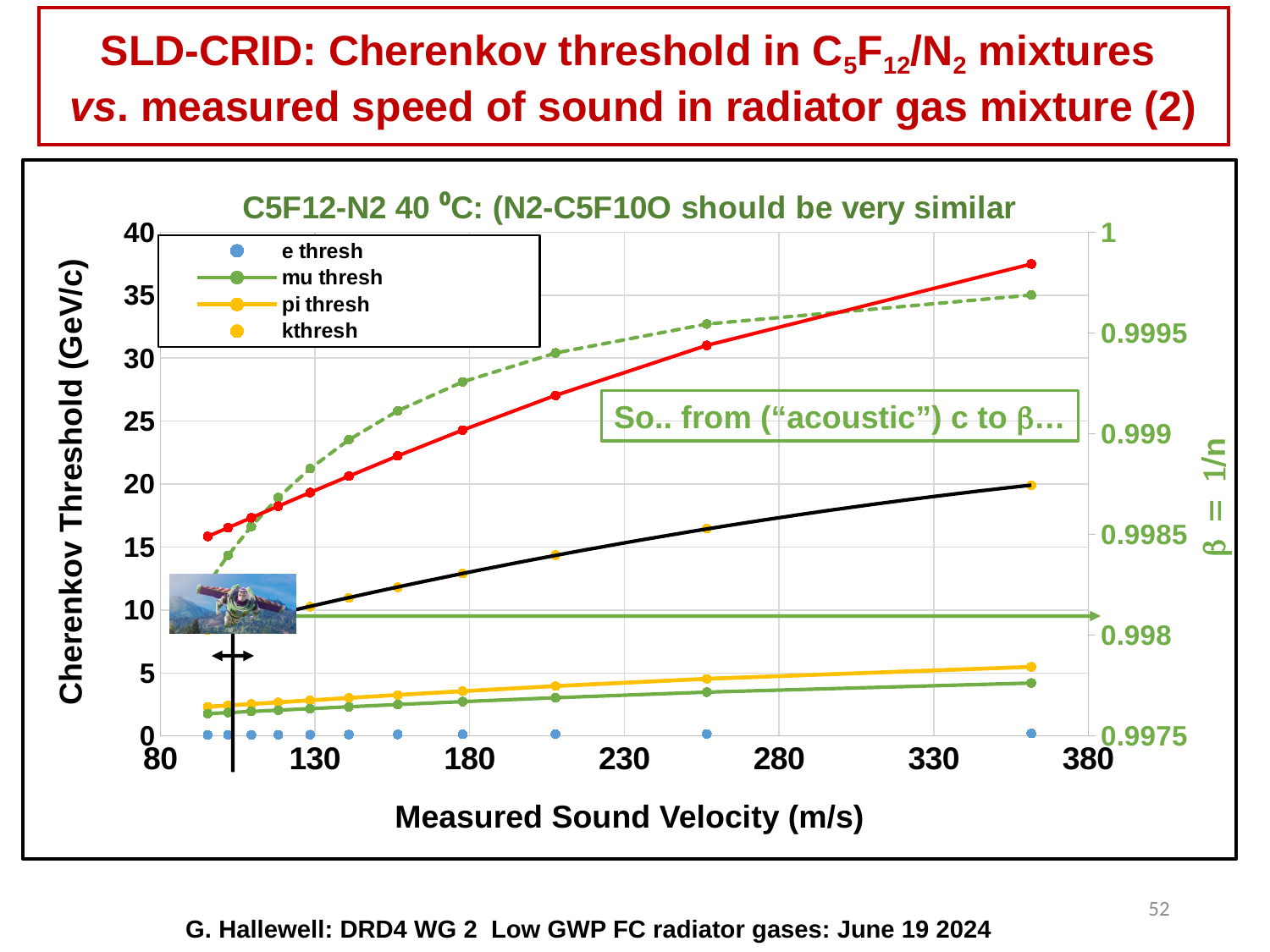
What is the title of the left y axis? Cherenkov Threshold (GeV/c) Is the value of the pi thresh series at its leftmost point greater or less than 10 GeV/c? less Is the value of the mu thresh series at its rightmost point greater or less than 5 GeV/c? less What kind of chart is shown on the slide? line chart How many series does the chart legend list? 4 What is the title of the x axis? Measured Sound Velocity (m/s) Does the mu thresh series rise or fall as measured sound velocity increases? rise Does the e thresh series rise, fall, or stay flat along the x axis? stay flat Is the value of the e thresh series at its rightmost point greater or less than 5 GeV/c? less At the rightmost data point, which is larger: pi thresh or mu thresh? pi thresh